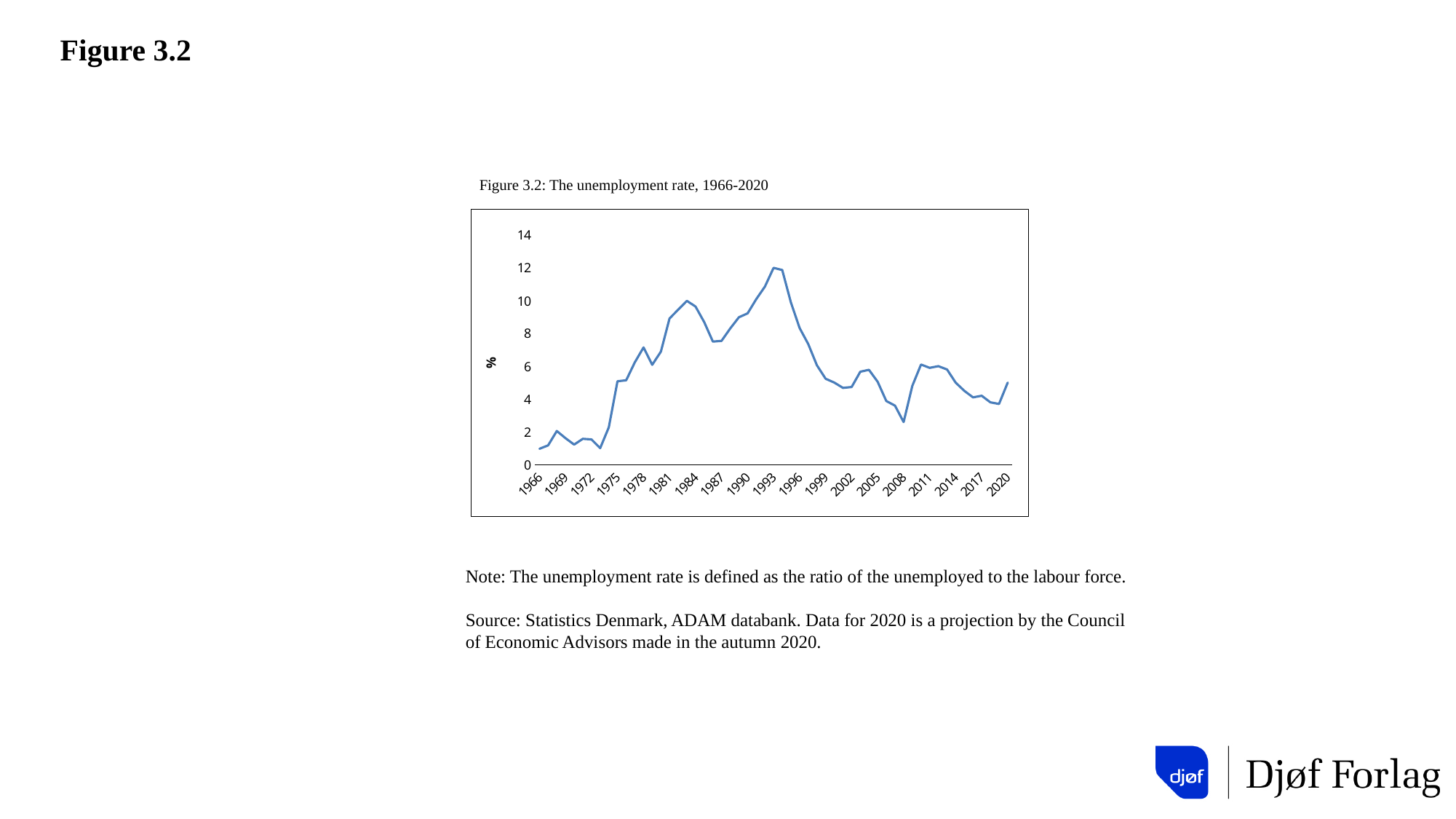
Is the unemployment rate in 1984 greater or less than 8? greater In which year shown on the x axis does the unemployment rate reach its highest point? 1993 What label is shown on the vertical axis of the chart? % How many year labels are shown on the x axis? 19 Is the unemployment rate in 2020 greater or less than 4? greater What kind of chart is shown in Figure 3.2? line chart What is the title of the chart? Figure 3.2: The unemployment rate, 1966-2020 Which year has the higher unemployment rate, 1984 or 2011? 1984 Is the unemployment rate in 1966 greater or less than 2? less Does the unemployment rate rise or fall between 1993 and 1999? fall